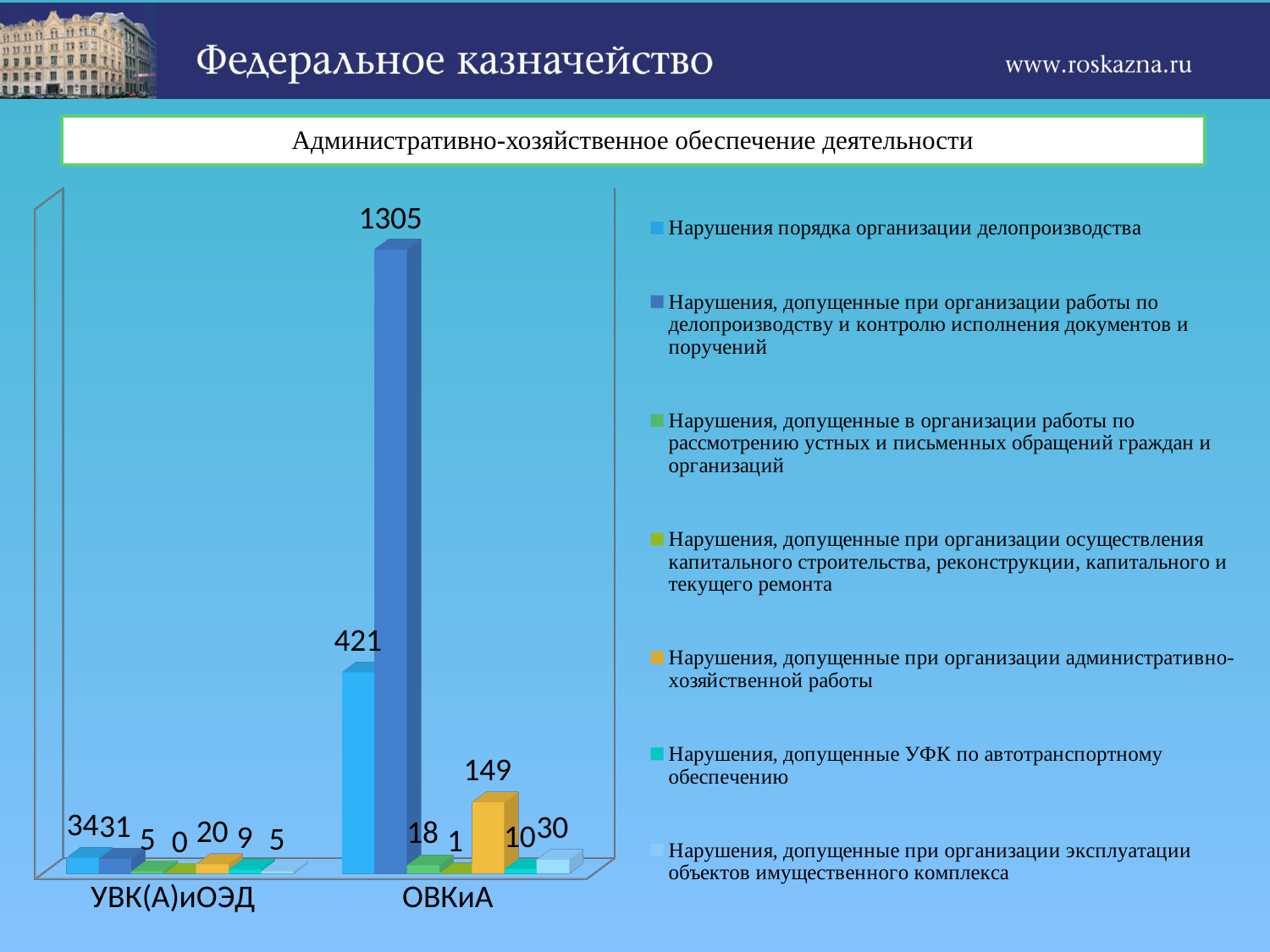
What is the value for ОВКиА in the series "Нарушения порядка организации делопроизводства"? 421 What is the difference between the УВК(А)иОЭД values for "Нарушения порядка организации делопроизводства" (34) and "Нарушения, допущенные при организации работы по делопроизводству и контролю исполнения документов и поручений" (31)? 3 What is the value for ОВКиА in the series "Нарушения, допущенные при организации работы по делопроизводству и контролю исполнения документов и поручений"? 1305 Which is larger for ОВКиА: the value for "Нарушения, допущенные при организации административно-хозяйственной работы" or the value for "Нарушения, допущенные при организации эксплуатации объектов имущественного комплекса"? Нарушения, допущенные при организации административно-хозяйственной работы What type of chart is shown on the slide? bar chart Which category has the highest value in the series "Нарушения, допущенные при организации работы по делопроизводству и контролю исполнения документов и поручений"? ОВКиА How many series does the chart legend list? 7 What is the value for ОВКиА in the series "Нарушения, допущенные при организации административно-хозяйственной работы"? 149 What is the difference between the ОВКиА values for "Нарушения, допущенные при организации работы по делопроизводству и контролю исполнения документов и поручений" (1305) and "Нарушения порядка организации делопроизводства" (421)? 884 What is the value for УВК(А)иОЭД in the series "Нарушения порядка организации делопроизводства"? 34 What is the title shown above the chart on the slide? Административно-хозяйственное обеспечение деятельности How many categories are shown on the x axis of the chart? 2